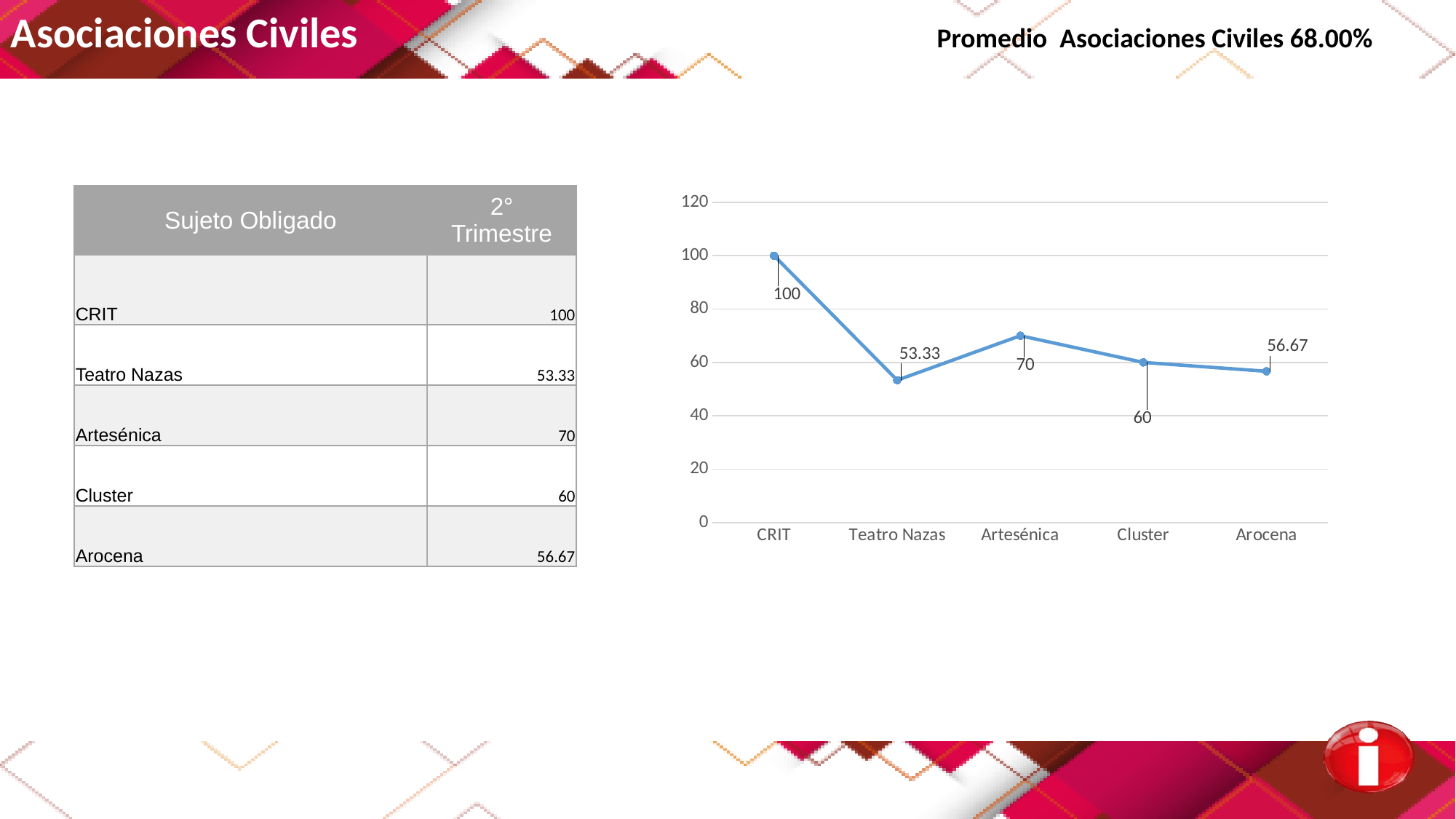
Is the value for Cluster greater or less than 80? less Does the value rise or fall from CRIT to Teatro Nazas? fall Which category has the highest value in the chart? CRIT What is the value for Arocena in the chart? 56.67 Which category has the lowest value in the chart? Teatro Nazas What is the value for Artesénica in the chart? 70 What is the difference between the values for CRIT and Cluster? 40 What is the value for CRIT in the chart? 100 What kind of chart is shown on the slide? line chart How many categories are plotted on the x axis of the chart? 5 What is the value for Teatro Nazas in the chart? 53.33 Which is larger, the value for Artesénica or the value for Arocena? Artesénica